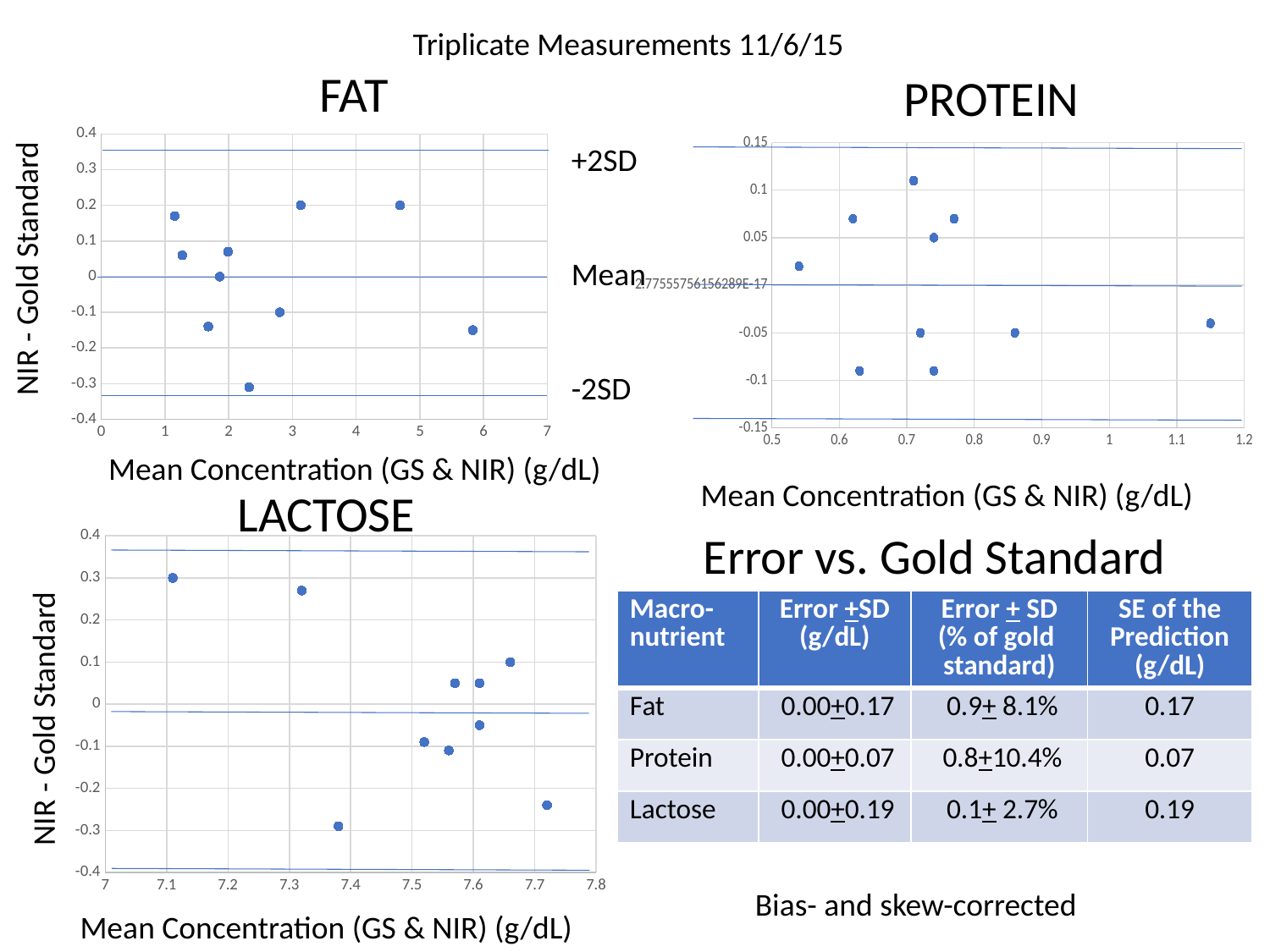
What is the maximum value shown on the y axis of the PROTEIN chart? 0.15 In the LACTOSE chart, is the value for the point with the largest mean concentration (near 7.7 g/dL) greater or less than -0.2? less How many data points are plotted in the FAT chart? 10 What is the y-axis title of the FAT chart? NIR - Gold Standard In the FAT chart, is the value for the point with the largest mean concentration (near 6 g/dL) greater or less than 0? less How many data points are plotted in the PROTEIN chart? 10 How many data points are plotted in the LACTOSE chart? 10 What kind of chart is the FAT chart? scatter chart In the PROTEIN chart, is the value for the point with the largest mean concentration (near 1.15 g/dL) greater or less than 0? less